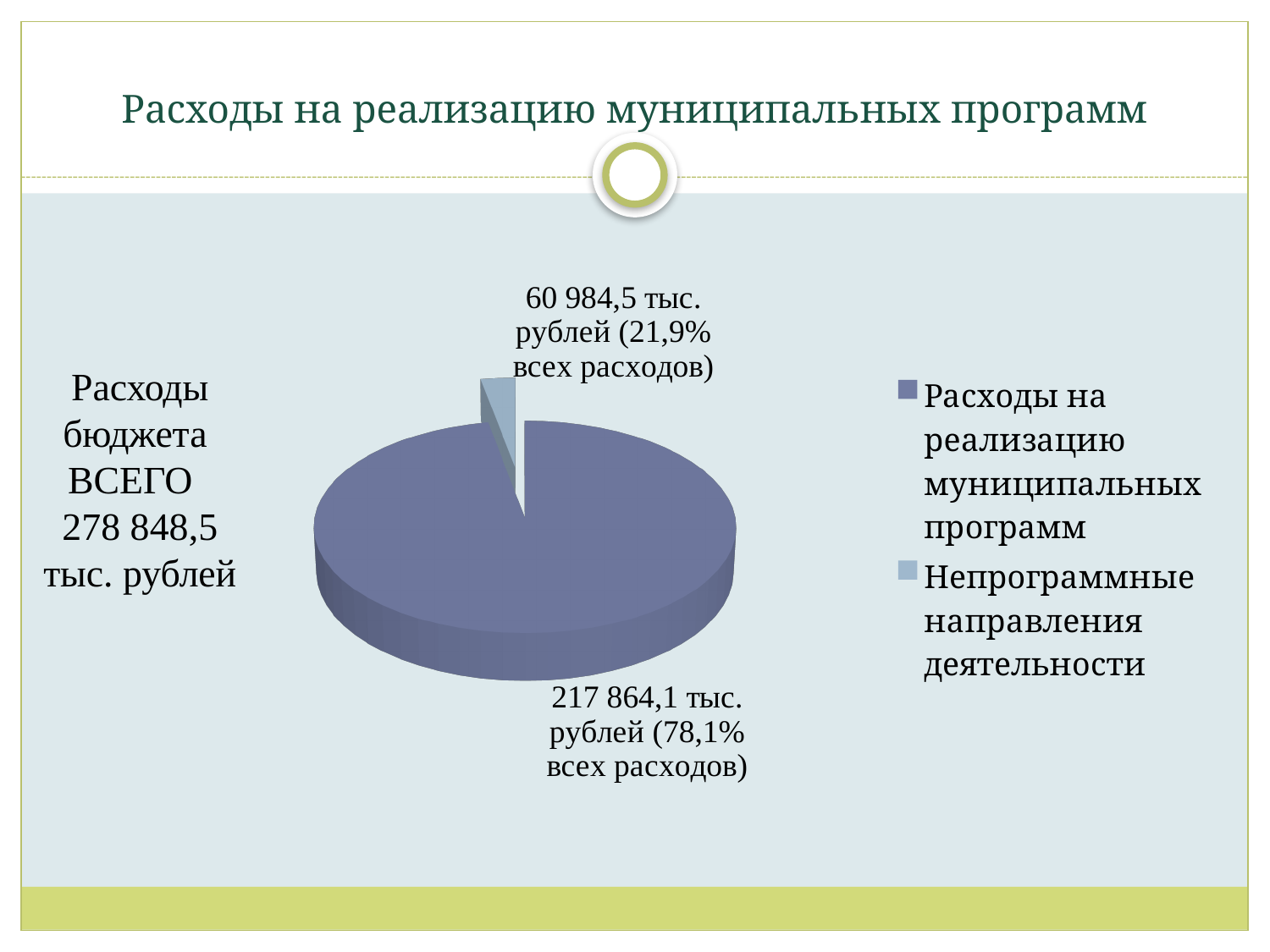
What is the title of the slide containing the pie chart? Расходы на реализацию муниципальных программ Which slice of the pie chart is the largest? Расходы на реализацию муниципальных программ How many entries does the legend of the pie chart list? 2 Which slice of the pie chart is the smallest? Непрограммные направления деятельности Which is larger: "Расходы на реализацию муниципальных программ" or "Непрограммные направления деятельности"? Расходы на реализацию муниципальных программ What is the value shown for "Непрограммные направления деятельности"? 60 984,5 тыс. рублей What share of all expenditures does "Непрограммные направления деятельности" represent? 21,9% What share of all expenditures does "Расходы на реализацию муниципальных программ" represent? 78,1% What is the value shown for "Расходы на реализацию муниципальных программ"? 217 864,1 тыс. рублей How many slices does the pie chart have? 2 What is the difference in тыс. рублей between "Расходы на реализацию муниципальных программ" and "Непрограммные направления деятельности"? 156 879,6 тыс. рублей What type of chart is shown on the slide? pie chart